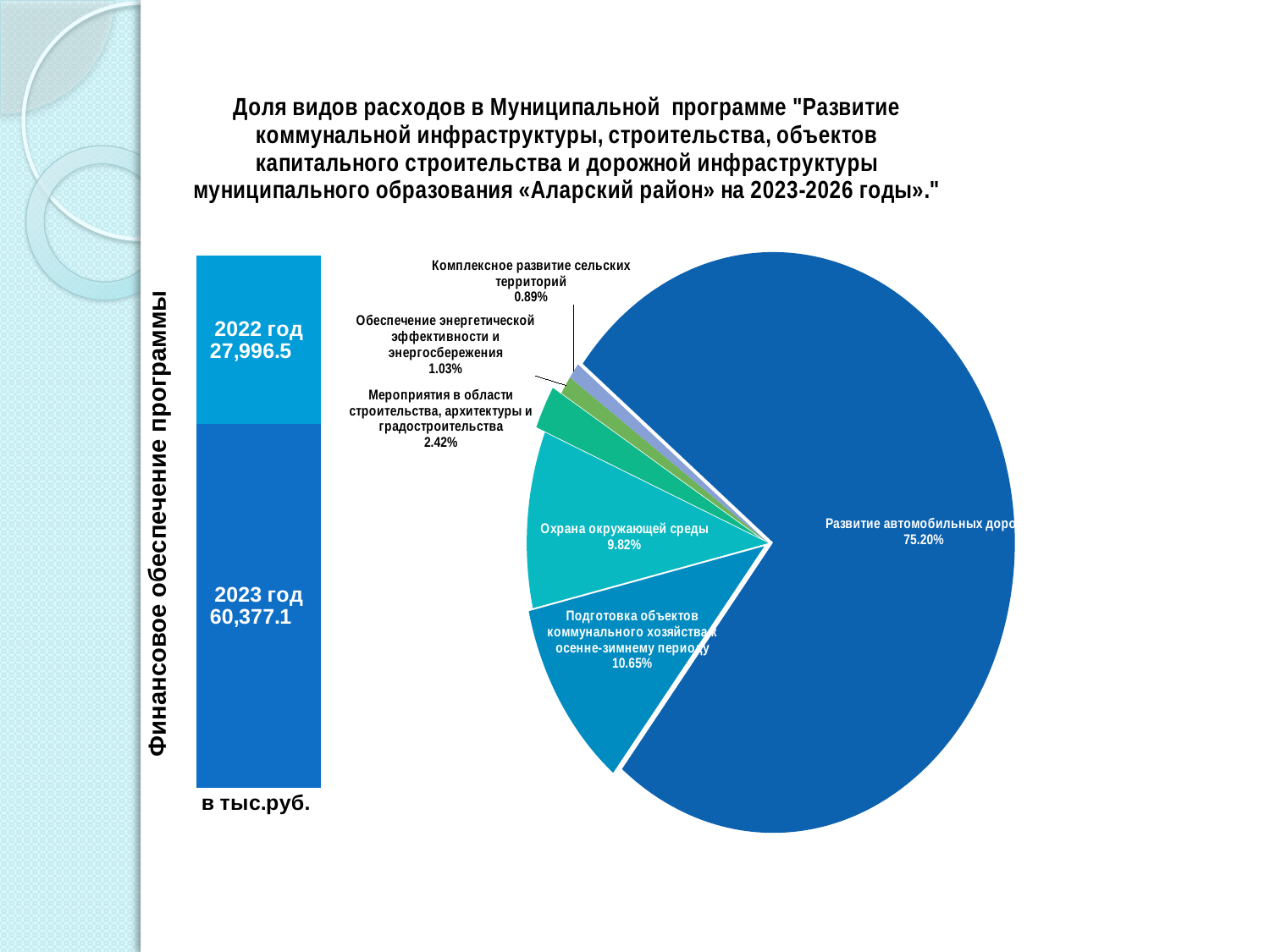
In the pie chart, how many slices are there? 6 In the pie chart, which category has the smallest share? Комплексное развитие сельских территорий In the pie chart, what share is shown for Охрана окружающей среды? 9.82% In the pie chart, which category has the largest share? Развитие автомобильных дорог In the pie chart, what share is shown for Обеспечение энергетической эффективности и энергосбережения? 1.03% In the pie chart, what share is shown for Комплексное развитие сельских территорий? 0.89% In the pie chart, which is larger: the share for Охрана окружающей среды or the share for Мероприятия в области строительства, архитектуры и градостроительства? Охрана окружающей среды What type of chart is the large chart on the right of the slide? Pie chart In the stacked bar on the left, what value is shown for 2022 год? 27,996.5 In the pie chart, what share is shown for Подготовка объектов коммунального хозяйства к осенне-зимнему периоду? 10.65% In the stacked bar on the left, what value is shown for 2023 год? 60,377.1 In the pie chart, what is the difference between the share for Подготовка объектов коммунального хозяйства к осенне-зимнему периоду and the share for Охрана окружающей среды? 0.83%